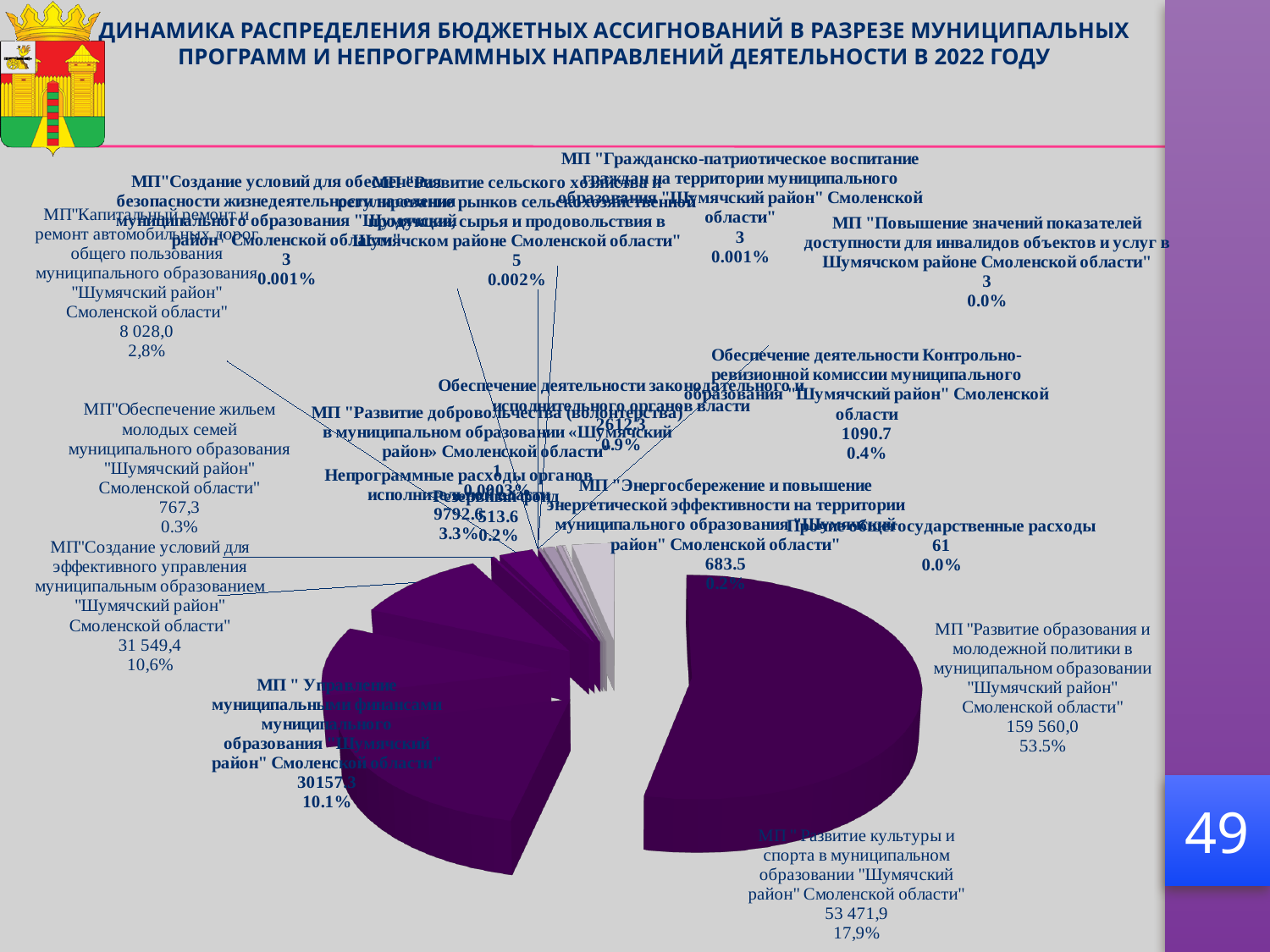
What kind of chart is shown on the slide? pie chart What percentage is shown for МП "Создание условий для эффективного управления муниципальным образованием "Шумячский район" Смоленской области"? 10,6% What share of the pie does МП "Развитие образования и молодежной политики" account for? 53.5% What value is shown for МП "Управление муниципальными финансами муниципального образования "Шумячский район" Смоленской области"? 30157.3 Which is larger: the value for МП "Развитие культуры и спорта" or the value for МП "Создание условий для эффективного управления муниципальным образованием"? МП "Развитие культуры и спорта" What value is shown for МП "Развитие образования и молодежной политики в муниципальном образовании "Шумячский район" Смоленской области"? 159 560,0 What value is shown for МП "Капитальный ремонт и ремонт автомобильных дорог общего пользования"? 8 028,0 What percentage is shown for МП "Обеспечение жильем молодых семей"? 0.3% What value is shown for МП "Развитие культуры и спорта в муниципальном образовании "Шумячский район" Смоленской области"? 53 471,9 What value is shown for Непрограммные расходы органов исполнительной власти? 9792.6 What is the difference between the value for МП "Развитие образования и молодежной политики" (159 560,0) and the value for МП "Развитие культуры и спорта" (53 471,9)? 106 088,1 Which category has the largest share of the pie? МП "Развитие образования и молодежной политики в муниципальном образовании "Шумячский район" Смоленской области"